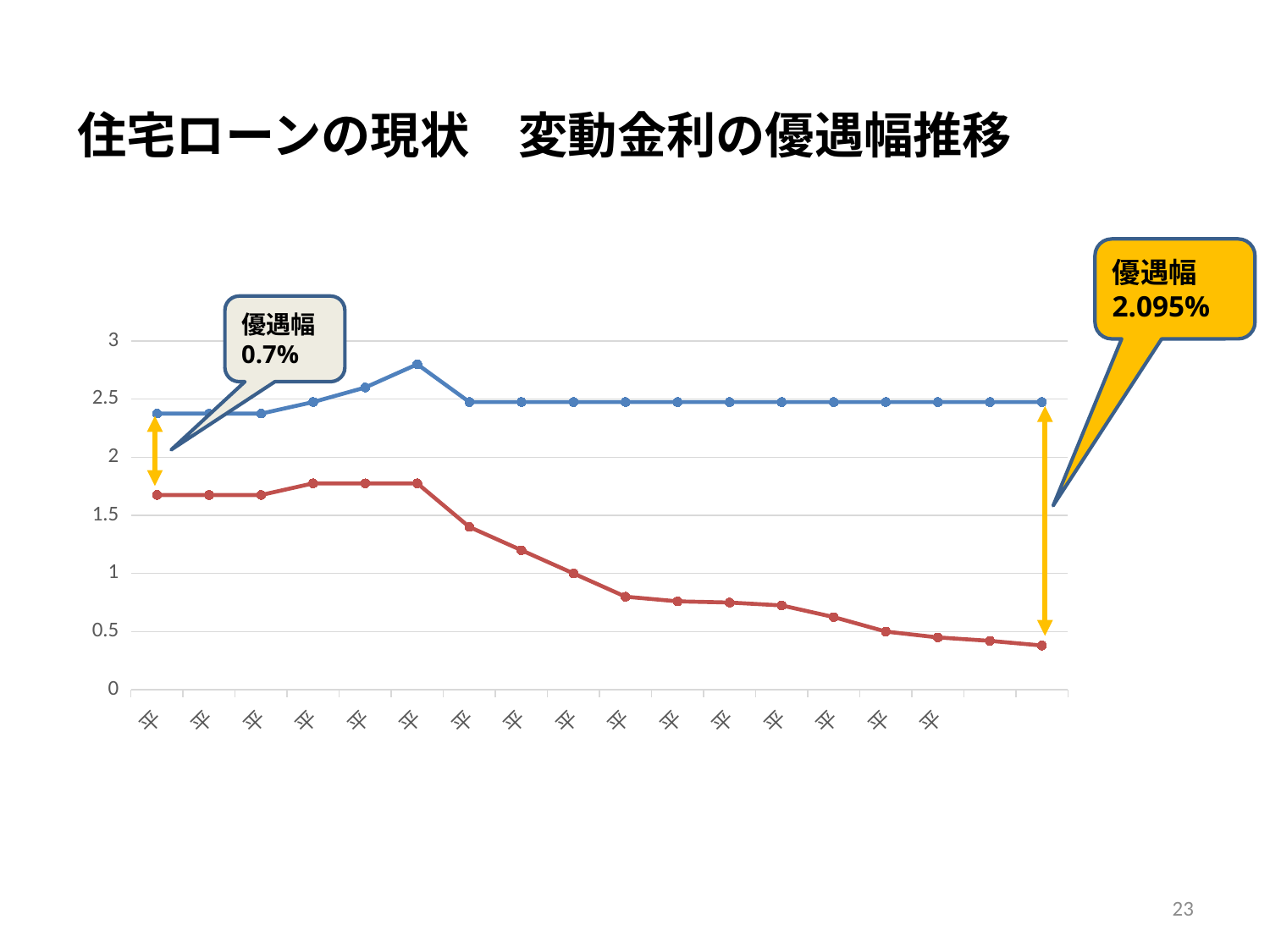
What colour is the line that stays above the other line across the whole chart? blue What 優遇幅 value does the callout at the left (start) of the chart show? 0.7% Does the red line rise or fall overall from left to right along the x axis? fall What kind of chart is shown on the slide? line chart At the last point on the x axis, which line has the larger value, the blue line or the red line? the blue line What is the title of the slide's chart? 住宅ローンの現状 変動金利の優遇幅推移 How many lines (series) are plotted in the chart? 2 Is the value of the first point on the red line greater or less than 1.5? greater Is the value of the last point on the red line greater or less than 0.5? less What 優遇幅 value does the callout at the right (end) of the chart show? 2.095% Is the highest point on the blue line greater or less than 2.5? greater How many data points does the blue line have? 18